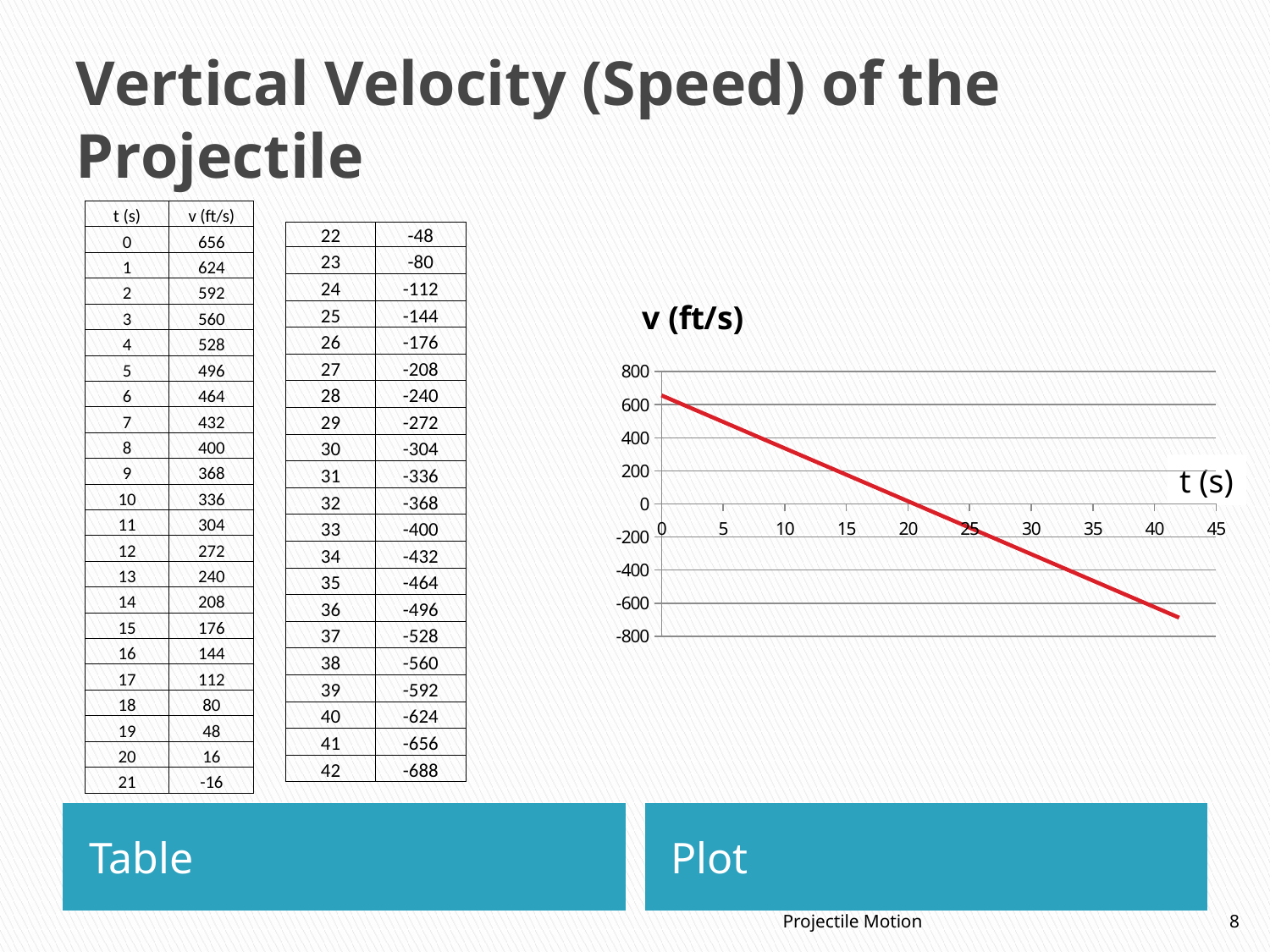
Do the values on the chart rise or fall as t increases? fall According to the table on the slide, what is v at t = 42? -688 Which is larger, the value at t = 5 or the value at t = 35? t = 5 According to the table on the slide, what is v at t = 0? 656 At which value of t is the plotted velocity highest? 0 Is the value for t = 30 greater or less than -200? less Is the value for t = 40 greater or less than -400? less What is the label of the horizontal axis of the chart? t (s) Is the value for t = 10 greater or less than 200? greater What kind of chart is shown on the slide? line chart What is the title of the vertical axis of the chart? v (ft/s)